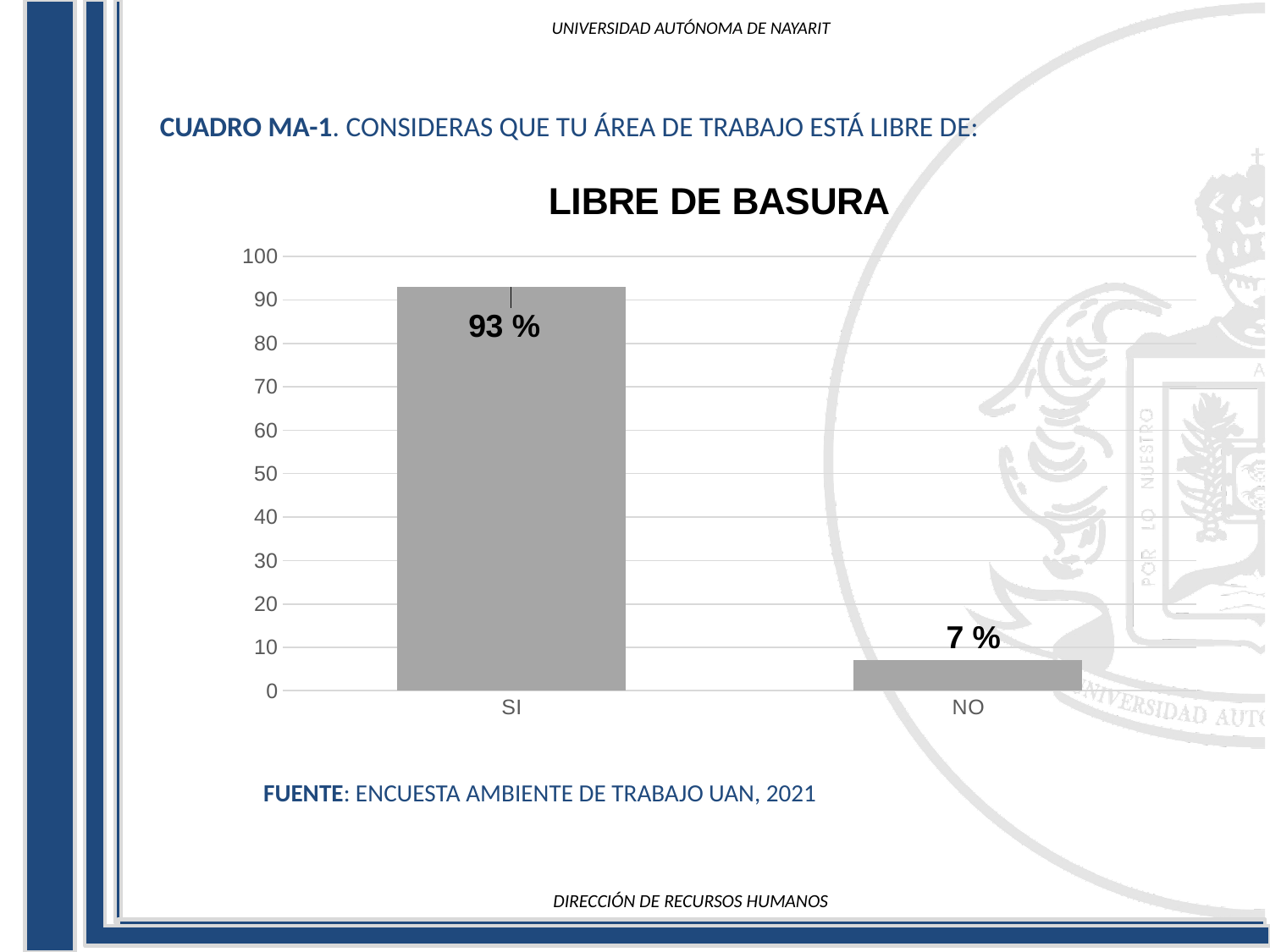
Which category has the highest value? SI Which is larger, the value for SI or the value for NO? SI Is the value for SI greater or less than 90? greater What is the value for SI? 93 % What is the maximum value shown on the y axis? 100 What kind of chart is shown? bar chart What is the title of the chart? LIBRE DE BASURA Is the value for NO greater or less than 10? less How many categories are shown on the x axis? 2 Which category has the lowest value? NO What is the value for NO? 7 % What is the difference between the values for SI and NO? 86 %